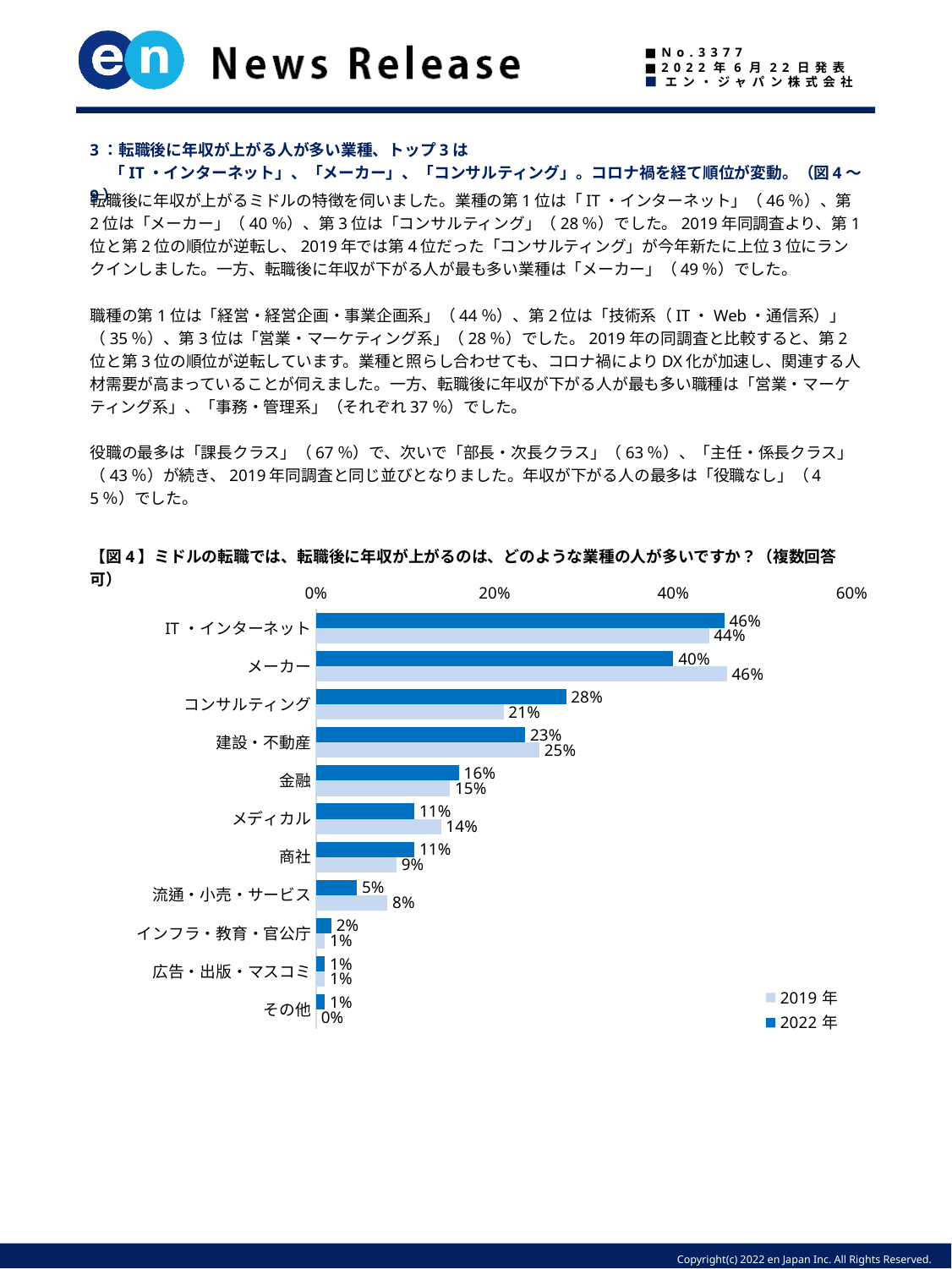
How many categories are shown on the chart? 11 Which category has the lowest 2019年 value? その他 Which is larger for メディカル, the 2019年 value or the 2022年 value? 2019年 How many series does the legend list? 2 What is the 2019年 value for メーカー? 46% Which category has the highest 2022年 value? IT・インターネット What is the 2022年 value for 建設・不動産? 23% What is the 2022年 value for コンサルティング? 28% What kind of chart is shown? bar chart What is the difference between the 2019年 and 2022年 values for メーカー? 6% What is the difference between the 2022年 and 2019年 values for コンサルティング? 7% Which series is shown in dark blue? 2022年